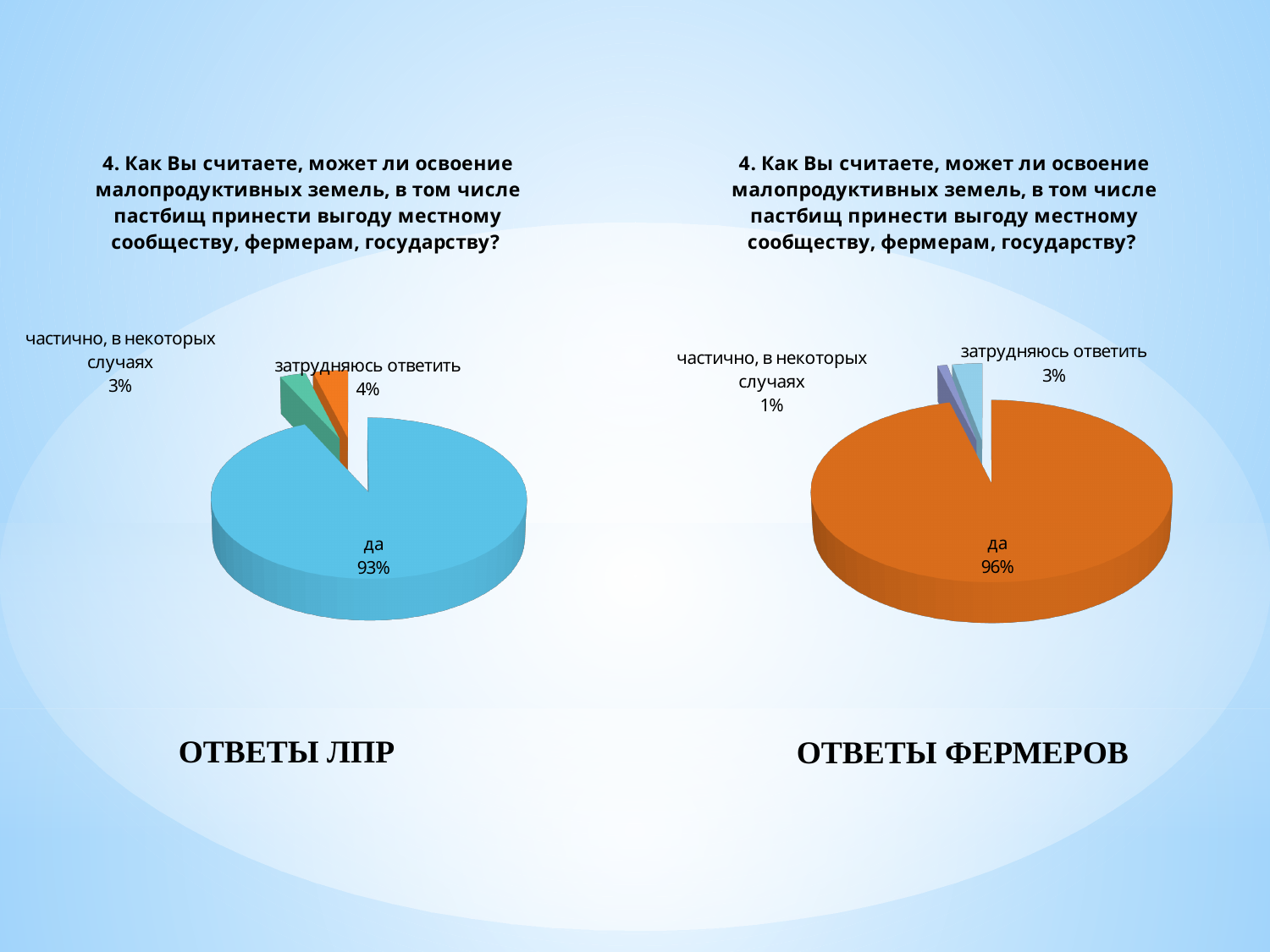
How many categories does the left pie chart (ОТВЕТЫ ЛПР) show? 3 What is the difference between the "да" share in the right chart (ОТВЕТЫ ФЕРМЕРОВ) and the "да" share in the left chart (ОТВЕТЫ ЛПР)? 3% In the left pie chart (ОТВЕТЫ ЛПР), what is the value for "затрудняюсь ответить"? 4% In the left pie chart (ОТВЕТЫ ЛПР), which category has the smallest share? частично, в некоторых случаях What colour is the "да" slice in the right pie chart (ОТВЕТЫ ФЕРМЕРОВ)? orange In the left pie chart (ОТВЕТЫ ЛПР), what is the difference between "затрудняюсь ответить" and "частично, в некоторых случаях"? 1% In the right pie chart (ОТВЕТЫ ФЕРМЕРОВ), what is the value for "частично, в некоторых случаях"? 1% In the left pie chart (ОТВЕТЫ ЛПР), what share of respondents answered "да"? 93% In the right pie chart (ОТВЕТЫ ФЕРМЕРОВ), what share of respondents answered "да"? 96% In the right pie chart (ОТВЕТЫ ФЕРМЕРОВ), which category has the largest share? да Which chart has the larger share for "затрудняюсь ответить": the left (ОТВЕТЫ ЛПР) or the right (ОТВЕТЫ ФЕРМЕРОВ)? the left (ОТВЕТЫ ЛПР) What type of chart is used on the right side of the slide (ОТВЕТЫ ФЕРМЕРОВ)? pie chart